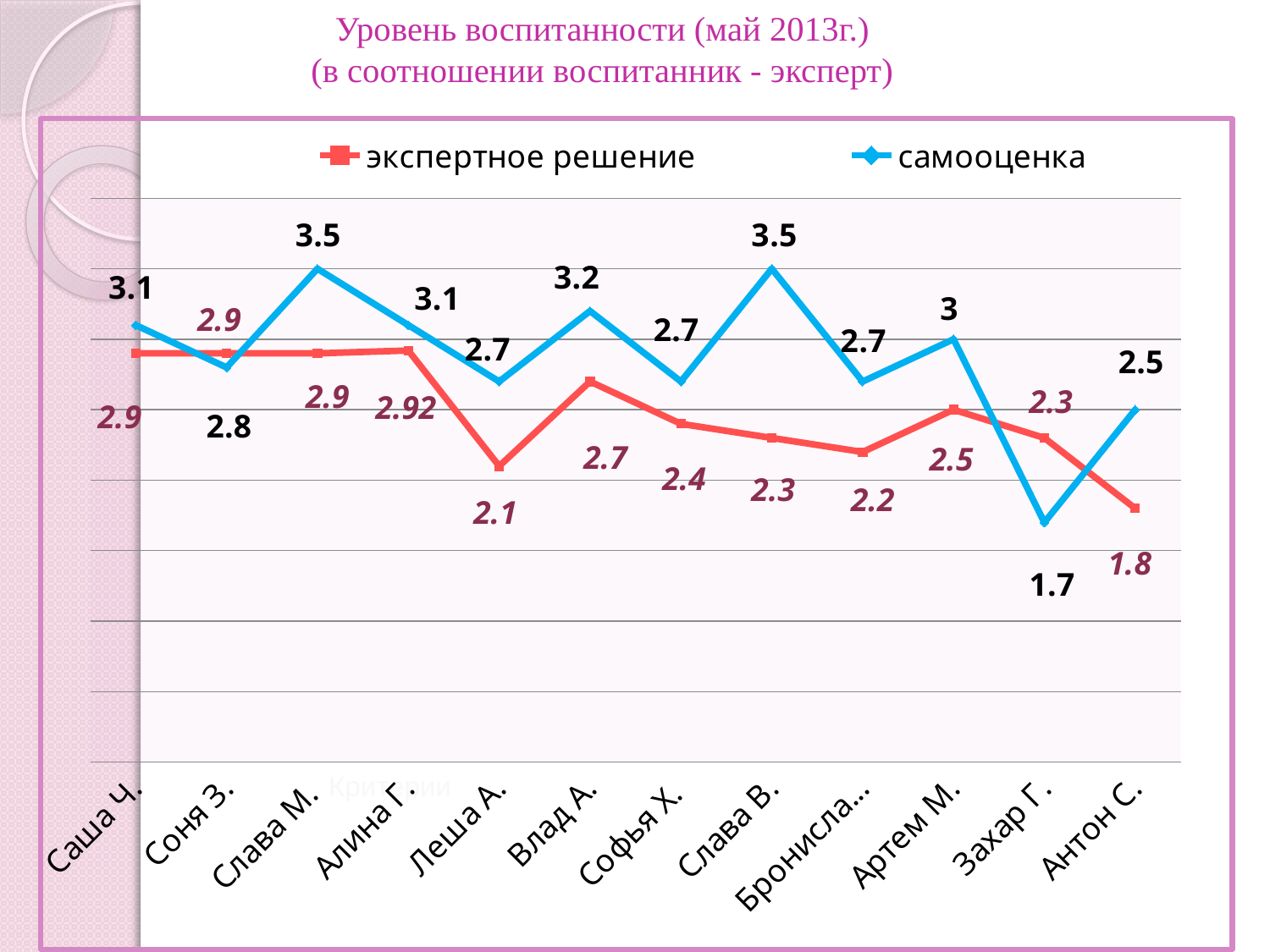
What kind of chart is shown on the slide? line chart For Захар Г., which is larger: экспертное решение or самооценка? экспертное решение How many series does the legend list? 2 What is the difference between the экспертное решение and самооценка values for Захар Г.? 0.6 What is the самооценка value for Захар Г.? 1.7 Which category has the lowest экспертное решение value? Антон С. What is the экспертное решение value for Леша А.? 2.1 What is the самооценка value for Слава М.? 3.5 What is the difference between the самооценка and экспертное решение values for Антон С.? 0.7 Which category has the lowest самооценка value? Захар Г. How many categories (names) are shown on the x axis? 12 What is the экспертное решение value for Алина Г.? 2.92